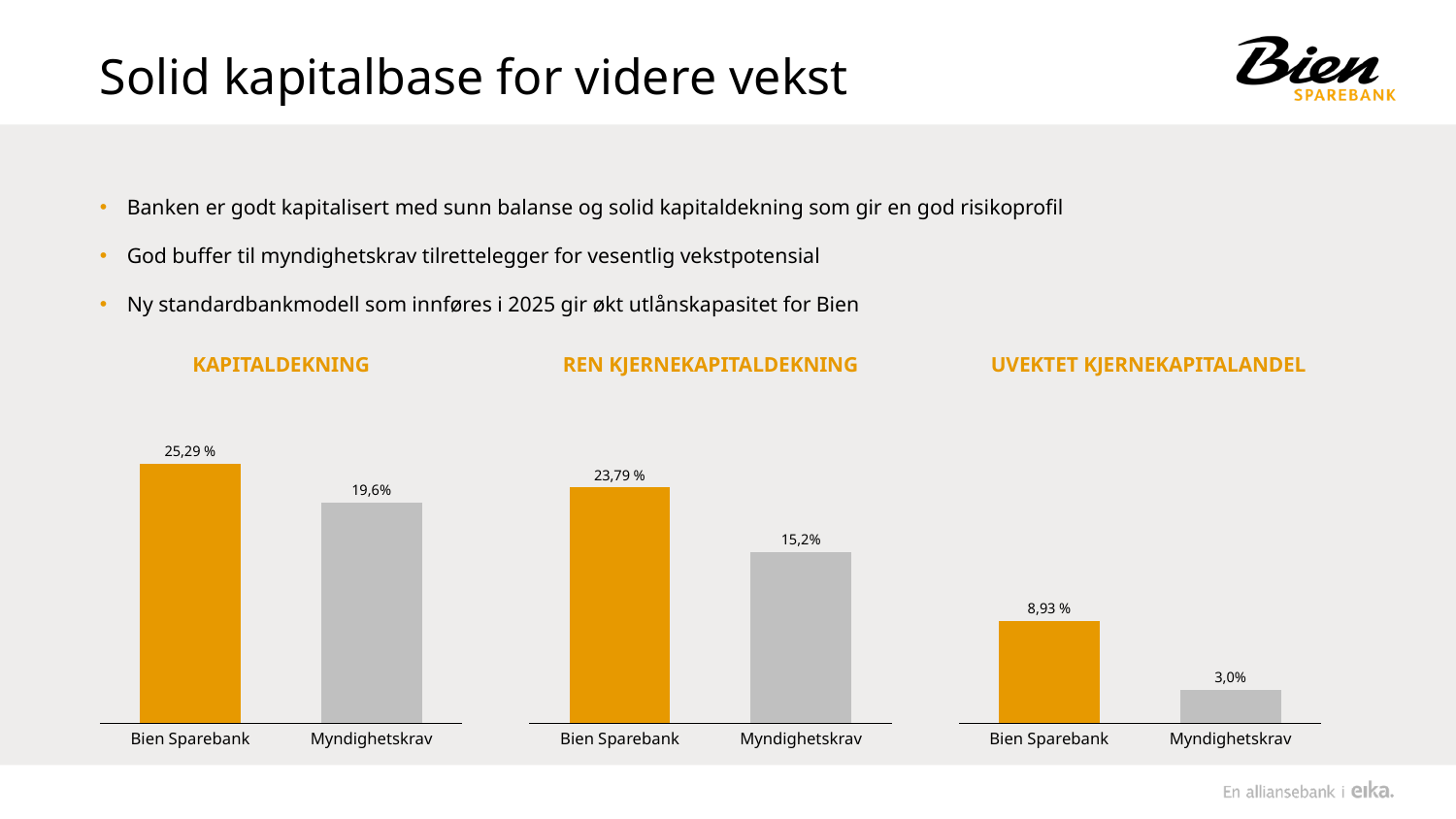
In the UVEKTET KJERNEKAPITALANDEL chart, what is the difference between Bien Sparebank and Myndighetskrav? 5,93 % In the REN KJERNEKAPITALDEKNING chart, what is the value for Myndighetskrav? 15,2% In the REN KJERNEKAPITALDEKNING chart, what is the value for Bien Sparebank? 23,79 % In the UVEKTET KJERNEKAPITALANDEL chart, what is the value for Bien Sparebank? 8,93 % How many categories are shown in the KAPITALDEKNING chart? 2 In the REN KJERNEKAPITALDEKNING chart, what is the difference between Bien Sparebank and Myndighetskrav? 8,59 % In the KAPITALDEKNING chart, what is the value for Myndighetskrav? 19,6% In the KAPITALDEKNING chart, which category has the highest value? Bien Sparebank In the UVEKTET KJERNEKAPITALANDEL chart, which category has the lowest value? Myndighetskrav What kind of chart is the REN KJERNEKAPITALDEKNING chart? Bar chart In the UVEKTET KJERNEKAPITALANDEL chart, what is the value for Myndighetskrav? 3,0% In the KAPITALDEKNING chart, what is the value for Bien Sparebank? 25,29 %